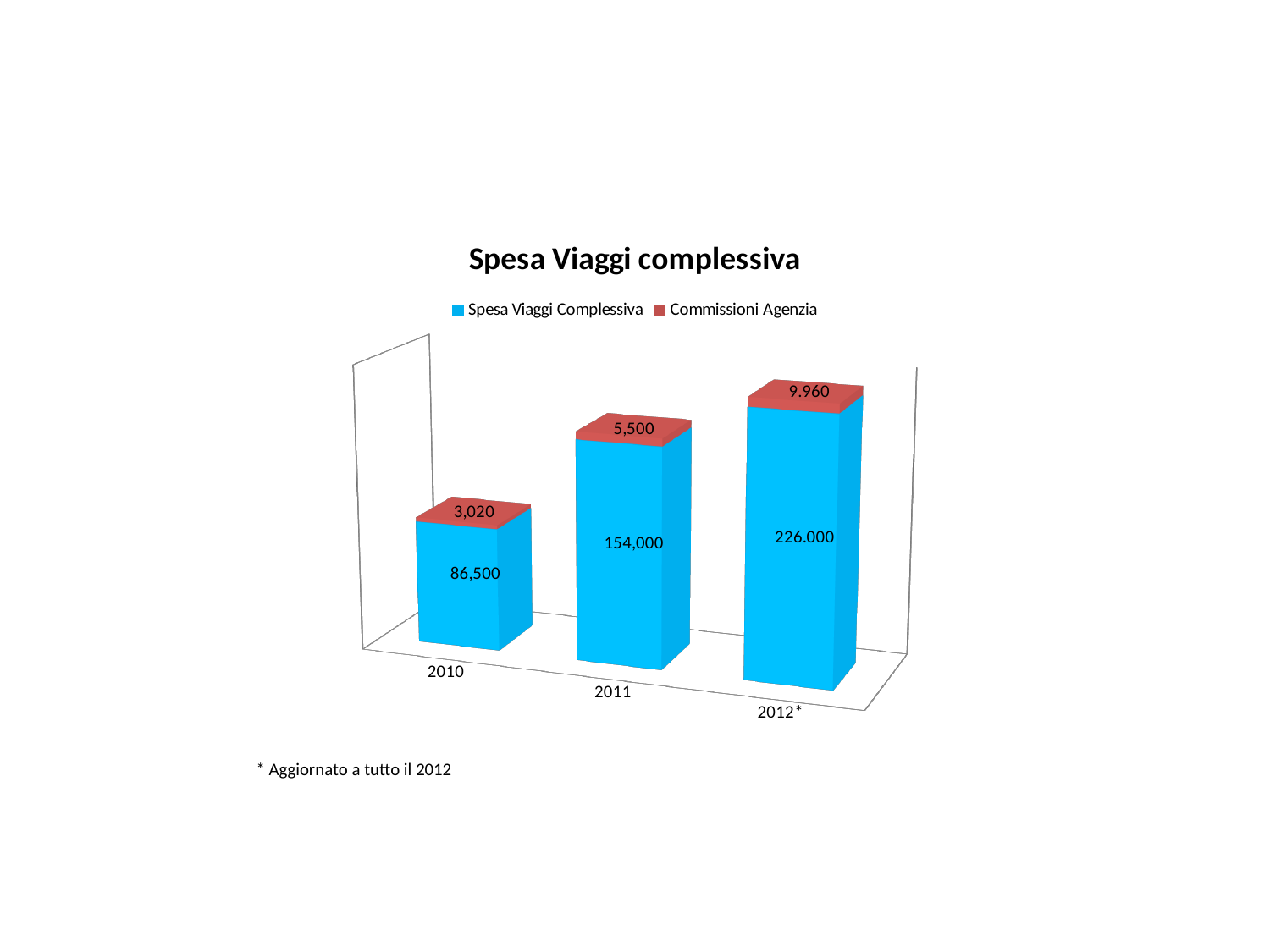
What is the value of Spesa Viaggi Complessiva for 2010? 86,500 What is the value of Commissioni Agenzia for 2011? 5,500 What type of chart is shown on the slide? bar chart What is the total of the stacked bar for 2011? 159,500 Which year has the highest Spesa Viaggi Complessiva? 2012* How many categories are shown on the x axis? 3 What is the difference in Spesa Viaggi Complessiva between 2011 and 2010? 67,500 What is the title of the chart? Spesa Viaggi complessiva What is the value of Commissioni Agenzia for 2012*? 9.960 What is the value of Spesa Viaggi Complessiva for 2012*? 226.000 Which year has the lowest Commissioni Agenzia? 2010 How many series does the legend list? 2